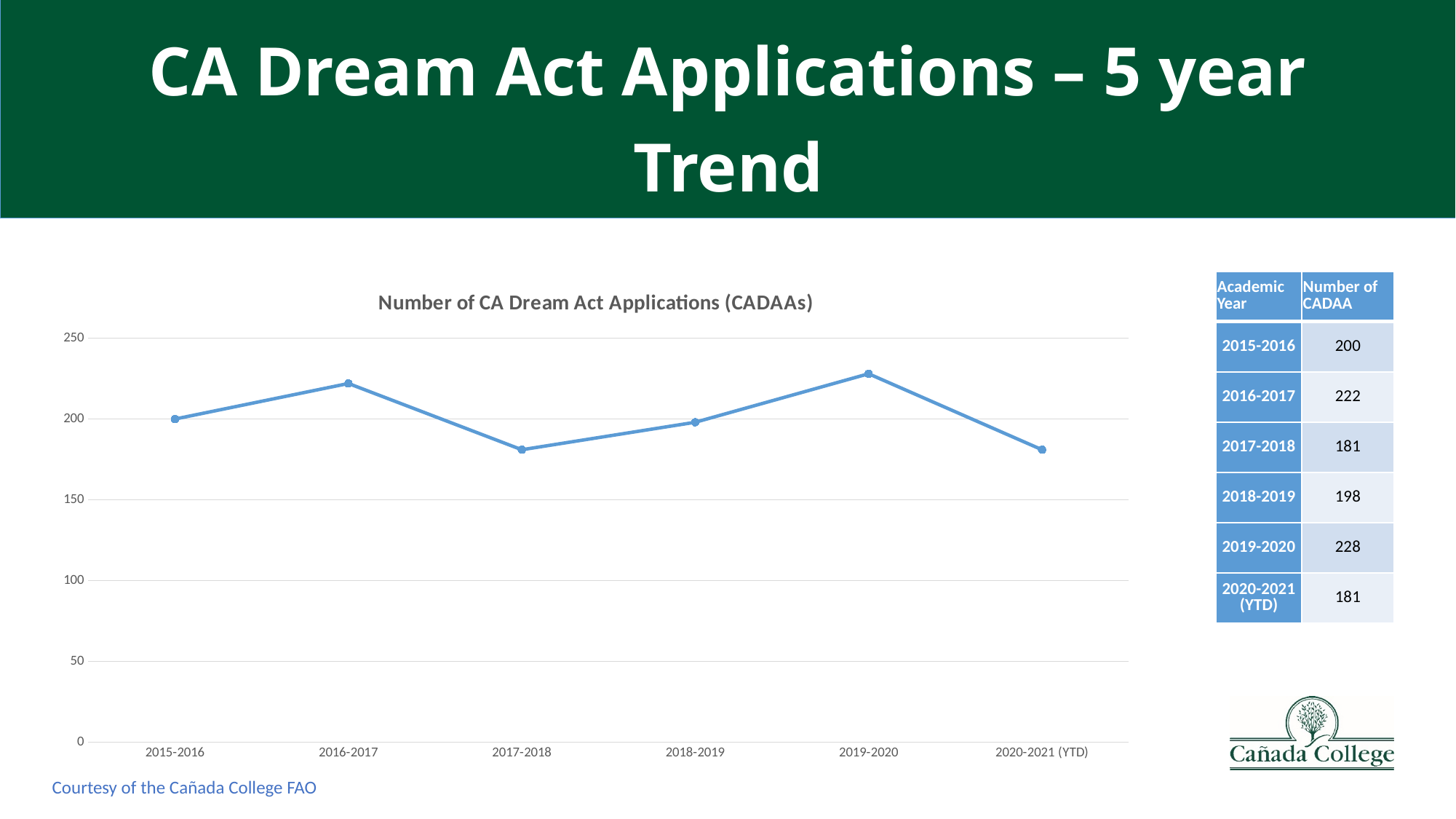
Is the value for 2017-2018 greater or less than 200? less What is the difference in applications between 2019-2020 and 2017-2018? 47 Which year had more applications, 2016-2017 or 2018-2019? 2016-2017 Which academic year has the highest number of CA Dream Act Applications? 2019-2020 What is the title of the chart? Number of CA Dream Act Applications (CADAAs) What is the difference in applications between 2016-2017 and 2015-2016? 22 What is the number of CA Dream Act Applications for 2015-2016? 200 How many academic years are plotted on the chart? 6 What is the number of CA Dream Act Applications for 2019-2020? 228 What is the number of CA Dream Act Applications for 2018-2019? 198 What type of chart is shown on the slide? line chart Do applications rise or fall from 2019-2020 to 2020-2021 (YTD)? fall